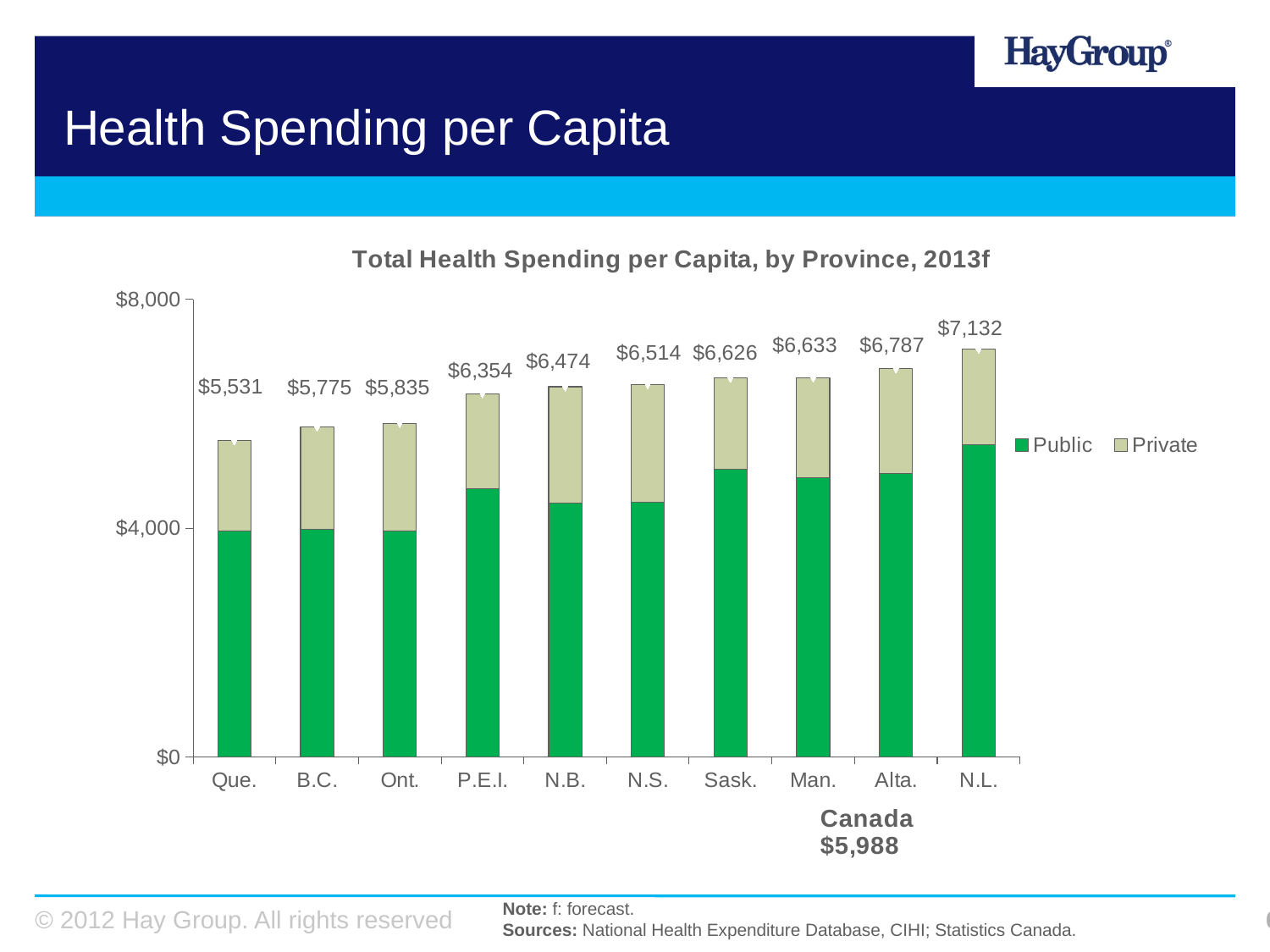
Do the total health spending values rise or fall from Que. to N.L. along the x axis? Rise What is the difference in total health spending per capita between Alta. and B.C.? $1,012 Is the Public spending value for N.L. greater or less than $4,000? greater How many series does the legend list? 2 What is the total health spending per capita for N.L.? $7,132 How many provinces are shown on the x axis of the chart? 10 Which province has the lowest total health spending per capita? Que. Which province has the highest total health spending per capita? N.L. Which has higher total health spending per capita, Ont. or N.B.? N.B. What kind of chart is shown on the slide? Stacked bar chart What is the total health spending per capita for P.E.I.? $6,354 What is the difference in total health spending per capita between N.L. and Que.? $1,601